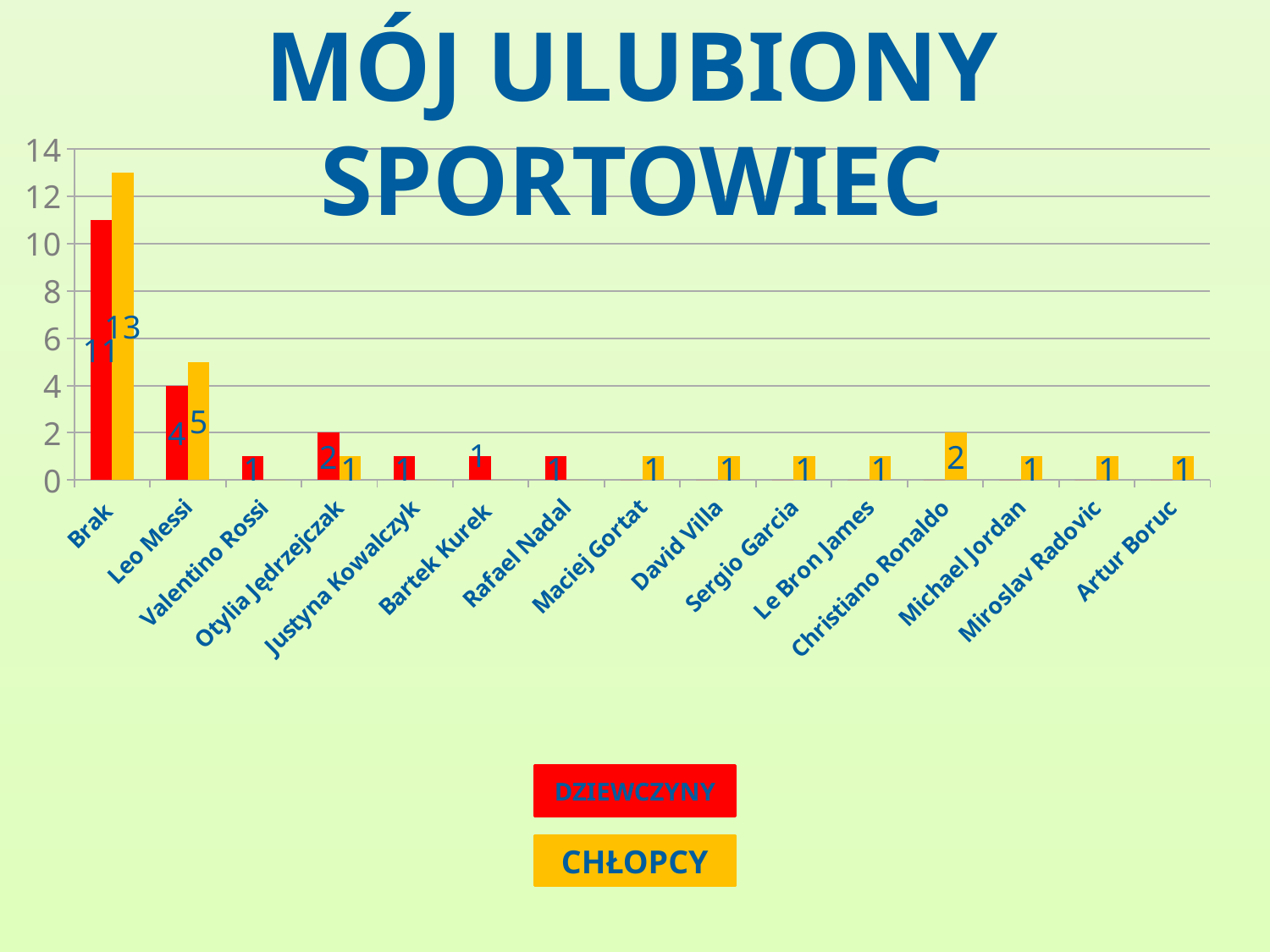
Is the DZIEWCZYNY value for Brak greater or less than 10? greater What is the CHŁOPCY value for Christiano Ronaldo? 2 How many categories are shown on the x axis? 15 Which category has the highest CHŁOPCY value? Brak What is the CHŁOPCY value for Leo Messi? 5 What kind of chart is shown on the slide? bar chart What is the DZIEWCZYNY value for Brak? 11 What is the CHŁOPCY value for Brak? 13 How many series does the legend list? 2 Which is larger for Leo Messi, the DZIEWCZYNY value or the CHŁOPCY value? CHŁOPCY What is the difference between the CHŁOPCY and DZIEWCZYNY values for Brak? 2 What is the DZIEWCZYNY value for Otylia Jędrzejczak? 2